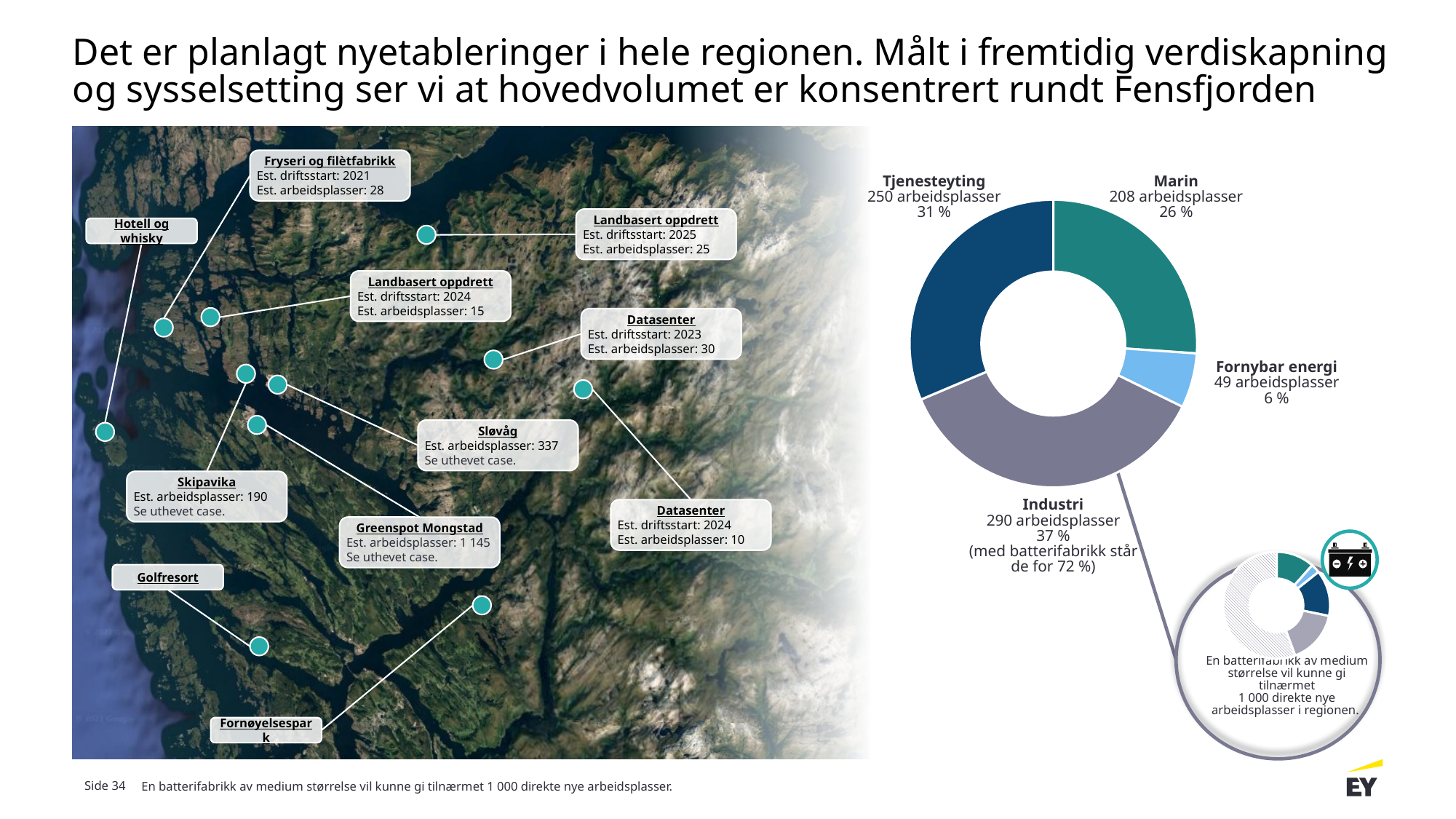
In the donut chart, what percentage share does Industri have? 37 % Which category in the donut chart has the lowest number of arbeidsplasser? Fornybar energi Which category in the donut chart has the highest number of arbeidsplasser? Industri In the donut chart, which has more arbeidsplasser, Tjenesteyting or Marin? Tjenesteyting How many categories does the donut chart on the right show? 4 In the donut chart, what percentage share does Tjenesteyting have? 31 % According to the donut chart label, what share does Industri account for when the battery factory is included? 72 % In the donut chart, what is the difference in arbeidsplasser between Industri and Tjenesteyting? 40 In the donut chart, how many arbeidsplasser are shown for Fornybar energi? 49 arbeidsplasser What kind of chart is shown on the right side of the slide? Pie chart (donut) In the donut chart, how many arbeidsplasser are shown for Industri? 290 arbeidsplasser In the donut chart, how many arbeidsplasser are shown for Marin? 208 arbeidsplasser